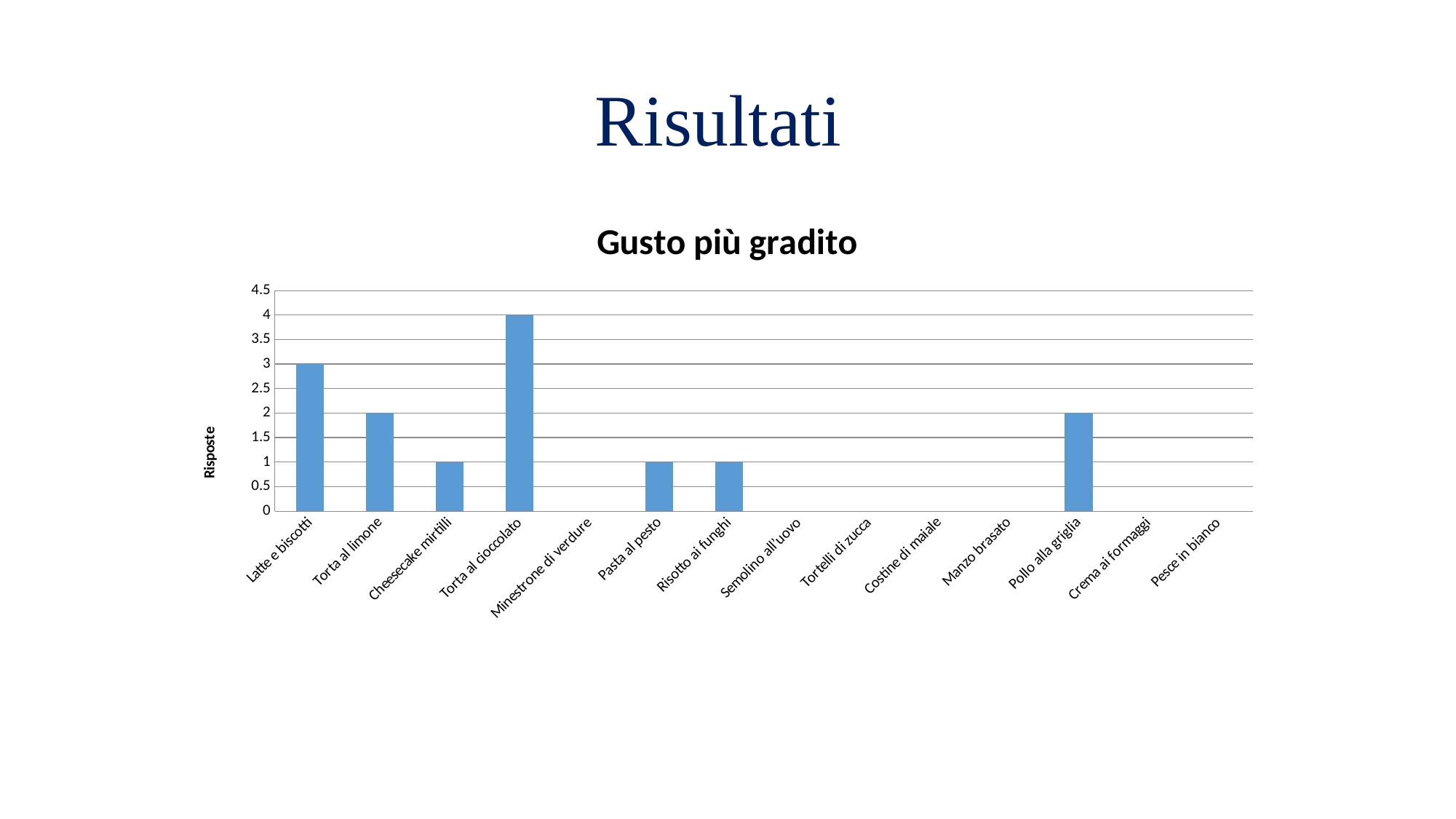
Which category has the highest value? Torta al cioccolato What is the difference between the values for Torta al cioccolato and Torta al limone? 2 What is the value for Cheesecake mirtilli? 1 What is the title of the chart? Gusto più gradito How many categories are shown on the x axis of the chart? 14 What is the label of the vertical axis? Risposte Is the value for Torta al cioccolato greater or less than 3.5? greater What is the value for Pollo alla griglia? 2 Which is larger, the value for Latte e biscotti or the value for Pasta al pesto? Latte e biscotti What kind of chart is shown on the slide? bar chart What is the value for Torta al cioccolato? 4 What is the value for Latte e biscotti? 3